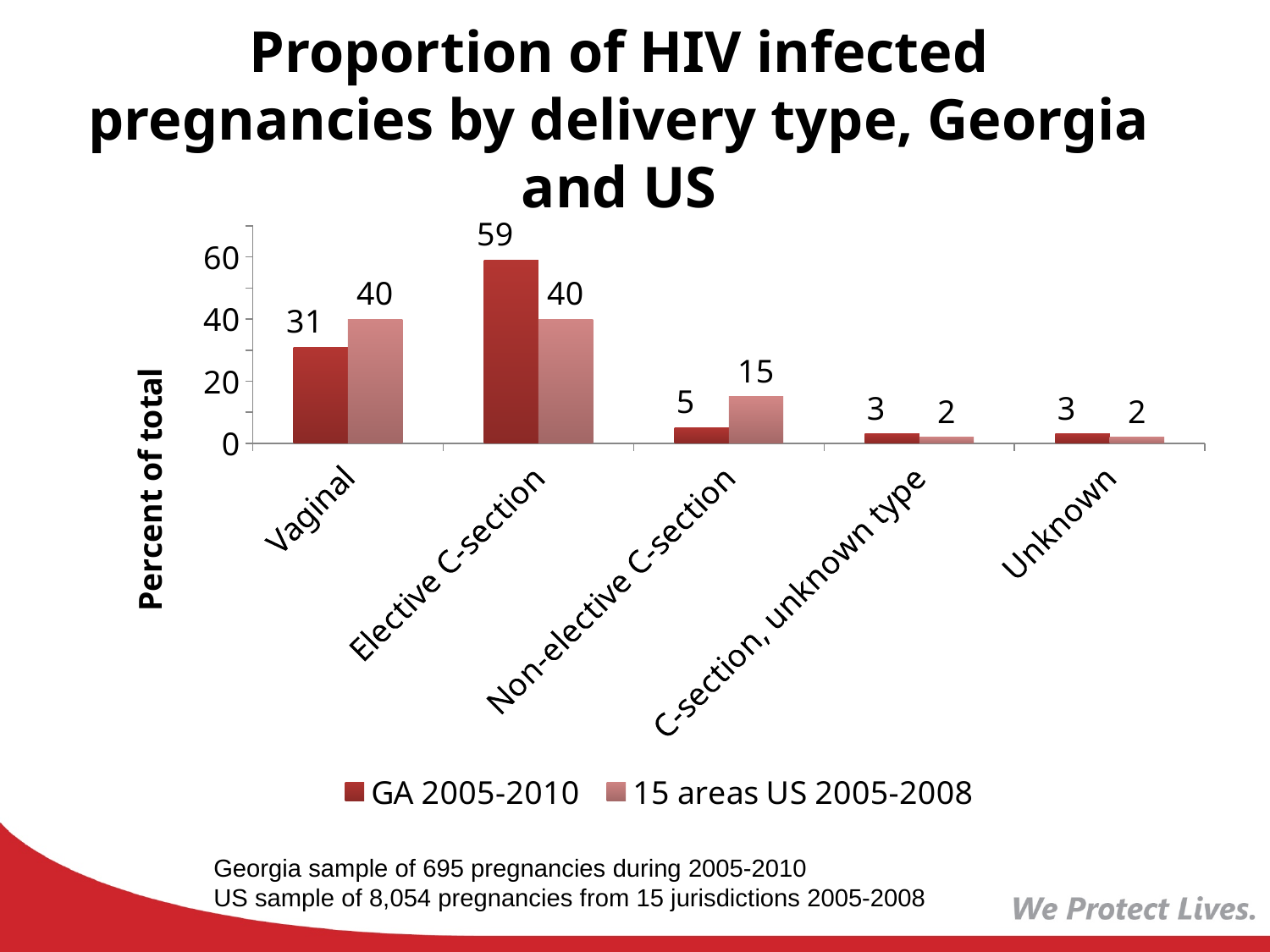
For Non-elective C-section, which series has the larger value, GA 2005-2010 or 15 areas US 2005-2008? 15 areas US 2005-2008 How many series does the legend list? 2 What kind of chart is shown on the slide? Bar chart What is the value for Vaginal delivery in the GA 2005-2010 series? 31 What is the value for Non-elective C-section in the GA 2005-2010 series? 5 What is the value for Elective C-section in the 15 areas US 2005-2008 series? 40 What is the label of the y axis? Percent of total Which delivery type has the highest value in the GA 2005-2010 series? Elective C-section How many delivery type categories are shown on the x axis? 5 What is the difference between the 15 areas US 2005-2008 and GA 2005-2010 values for Vaginal delivery? 9 What is the difference between the GA 2005-2010 and 15 areas US 2005-2008 values for Elective C-section? 19 Which delivery type has the lowest value in the 15 areas US 2005-2008 series? C-section, unknown type and Unknown (both 2)